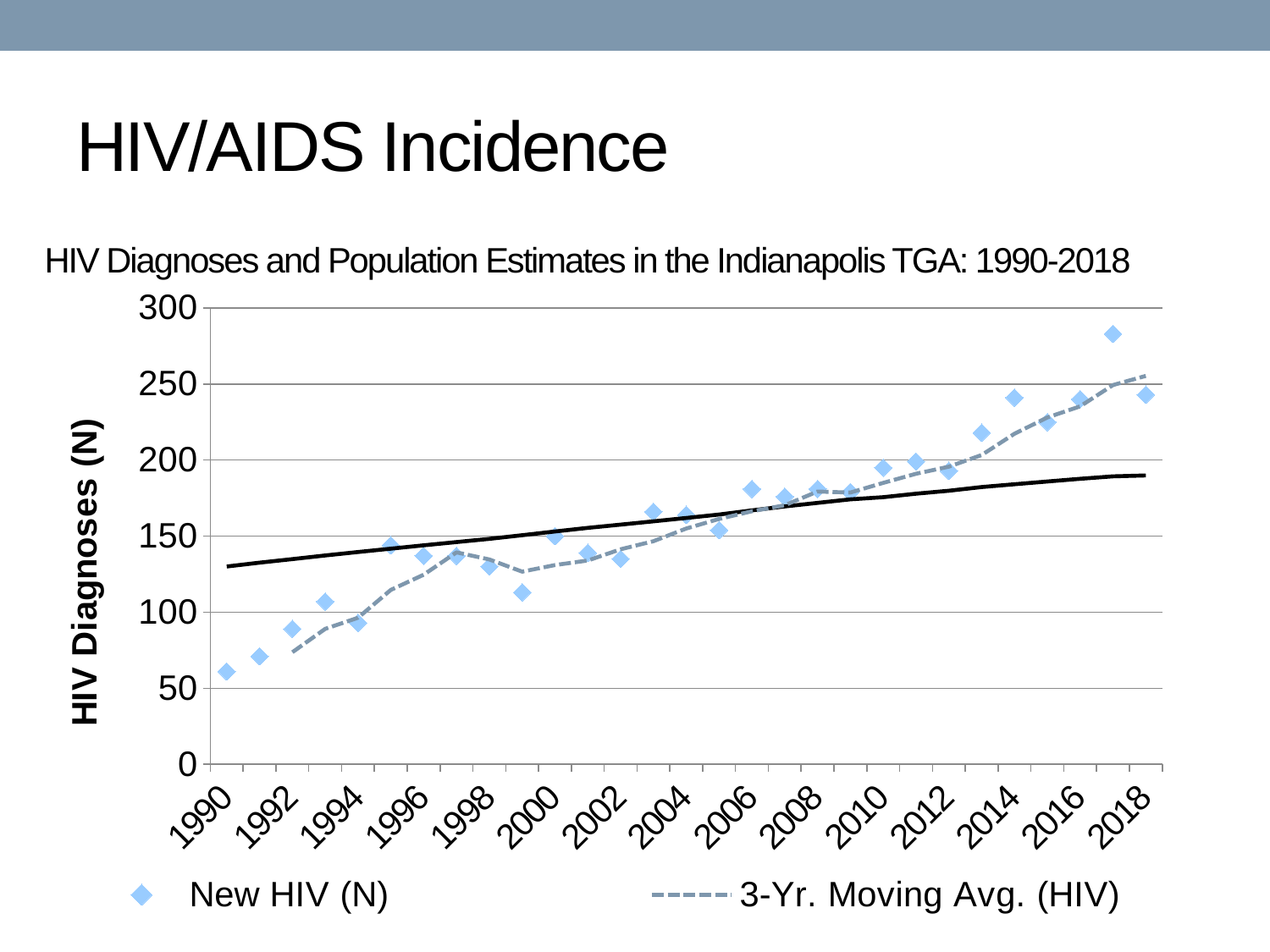
Is the New HIV (N) value for 2014 greater or less than 200? greater Is the New HIV (N) value for 2006 greater or less than 150? greater Is the New HIV (N) value for 2017 greater or less than 250? greater Overall, do the New HIV (N) values rise or fall from 1990 to 2018? rise What kind of chart is shown on the slide? line chart What is the title of the chart? HIV Diagnoses and Population Estimates in the Indianapolis TGA: 1990-2018 How many series does the legend list? 2 Which year has the larger New HIV (N) value, 2017 or 2018? 2017 In which year is the New HIV (N) value lowest? 1990 What is the label on the vertical axis of the chart? HIV Diagnoses (N) In which year is the New HIV (N) value highest? 2017